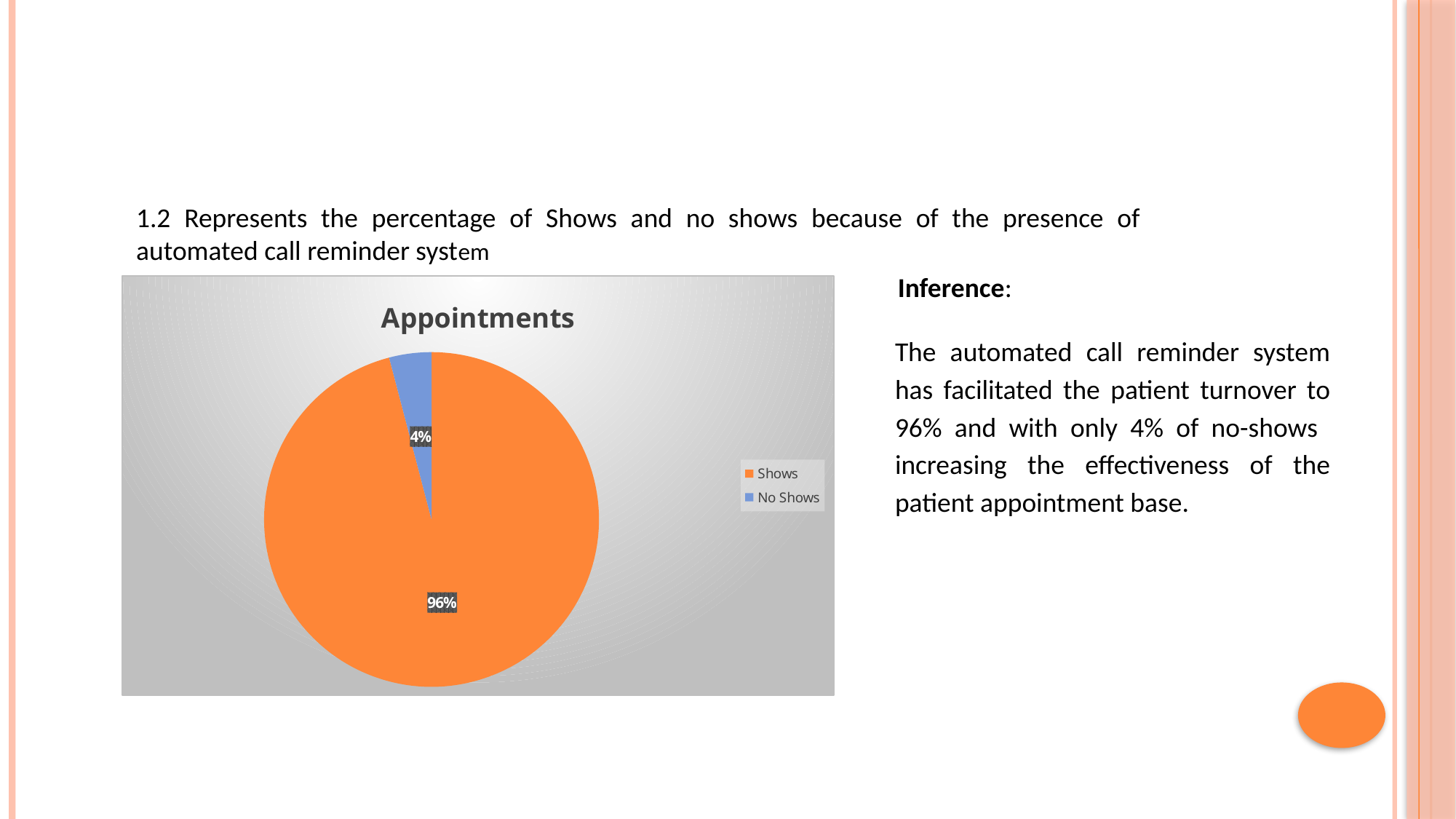
What kind of chart is shown on the slide? pie chart How many entries does the legend list? 2 Which is larger, the Shows slice or the No Shows slice? Shows What is the title of the chart? Appointments What colour is the No Shows slice? blue How many slices does the pie chart have? 2 Which slice of the pie is the smallest? No Shows What share of the pie does the Shows slice take? 96% Which slice of the pie is the largest? Shows What percentage of the pie is labelled for No Shows? 4% What is the difference in percentage points between the Shows slice and the No Shows slice? 92 What percentage of the pie is labelled for Shows? 96%